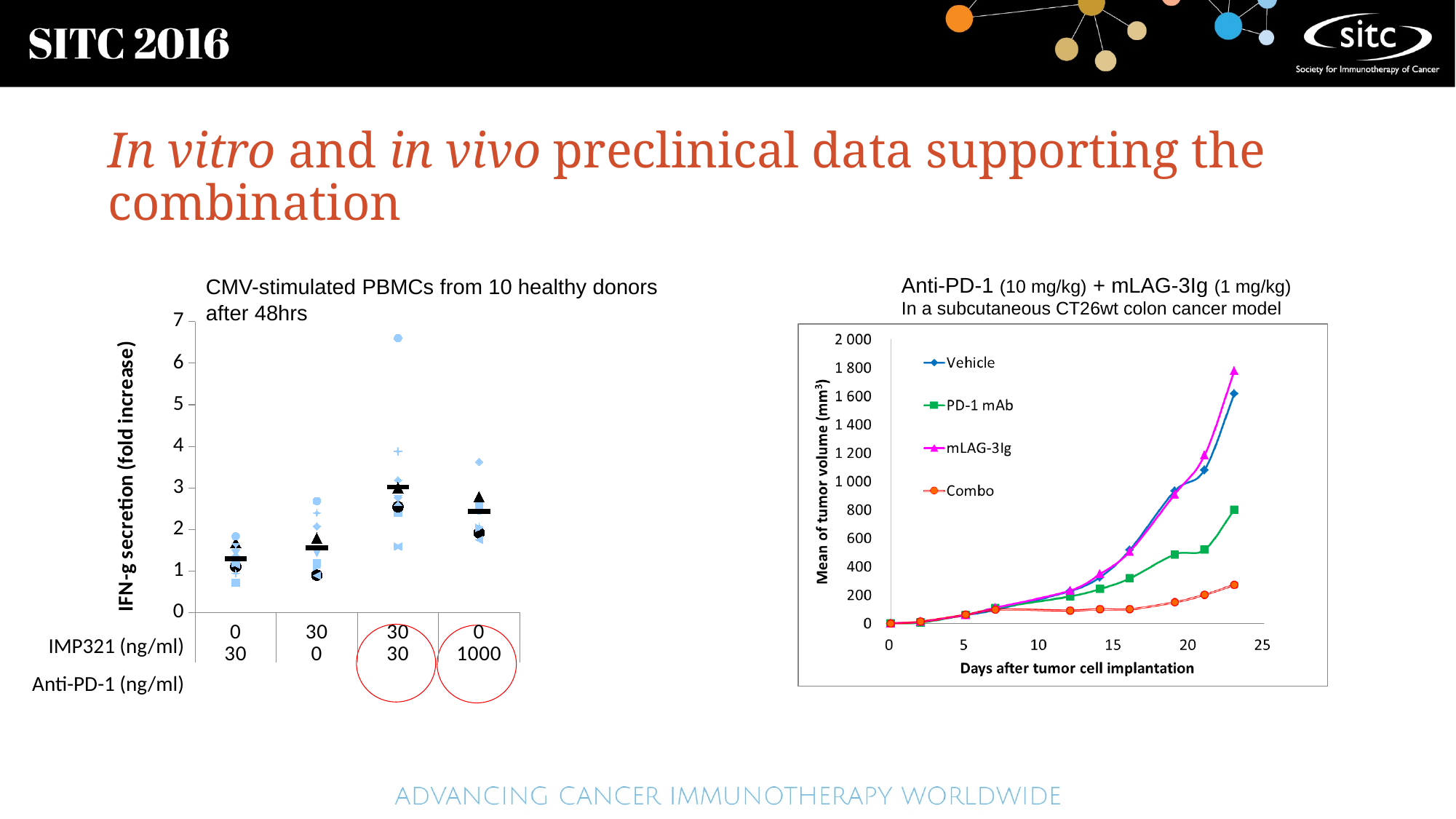
In the right chart (tumor volume), which series has the lowest mean tumor volume at the final time point? Combo In the right chart (tumor volume), at the final time point, which is larger: the PD-1 mAb value or the Combo value? PD-1 mAb In the left chart (CMV-stimulated PBMCs), is the highest individual data point in the IMP321 30 / Anti-PD-1 30 condition greater or less than 6? greater In the right chart, what is the label of the x axis? Days after tumor cell implantation In the right chart (tumor volume), is the final value for the Combo series greater or less than 400? less In the right chart (tumor volume), does the Vehicle series rise or fall over the days after tumor cell implantation? rise What kind of chart is the one on the right, titled 'Anti-PD-1 (10 mg/kg) + mLAG-3Ig (1 mg/kg)'? line chart In the right chart (tumor volume), which series has the highest mean tumor volume at the final time point? mLAG-3Ig In the right chart (tumor volume), how many series does the legend list? 4 In the right chart (tumor volume), is the final value for the Vehicle series greater or less than 1 400? greater In the left chart (CMV-stimulated PBMCs), how many treatment conditions are shown on the x axis? 4